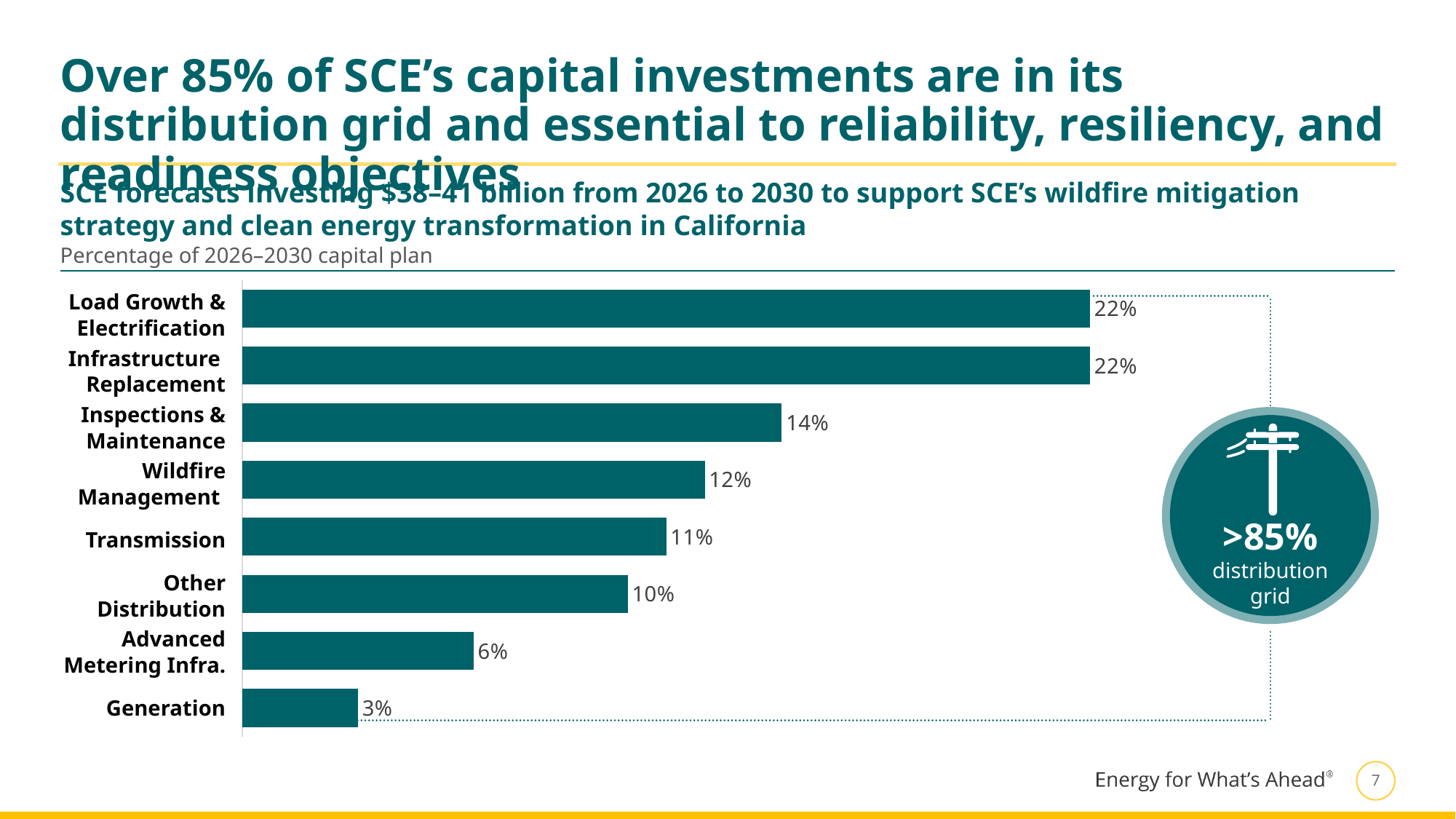
What is the difference between the Infrastructure Replacement and Other Distribution percentages? 12% What kind of chart is shown on the slide? Bar chart What percentage of the capital plan is allocated to Wildfire Management? 12% How many categories are shown in the bar chart? 8 Which category has the lowest percentage of the capital plan? Generation What percentage of the 2026–2030 capital plan is for Inspections & Maintenance? 14% What is the combined percentage for Load Growth & Electrification and Infrastructure Replacement? 44% Which is larger, the value for Wildfire Management or the value for Transmission? Wildfire Management What percentage is shown in the circle to the right of the chart for the distribution grid? >85% What is the value shown for Transmission? 11% What percentage of the capital plan goes to Advanced Metering Infra.? 6% What does the chart's subtitle say the bars represent? Percentage of 2026–2030 capital plan